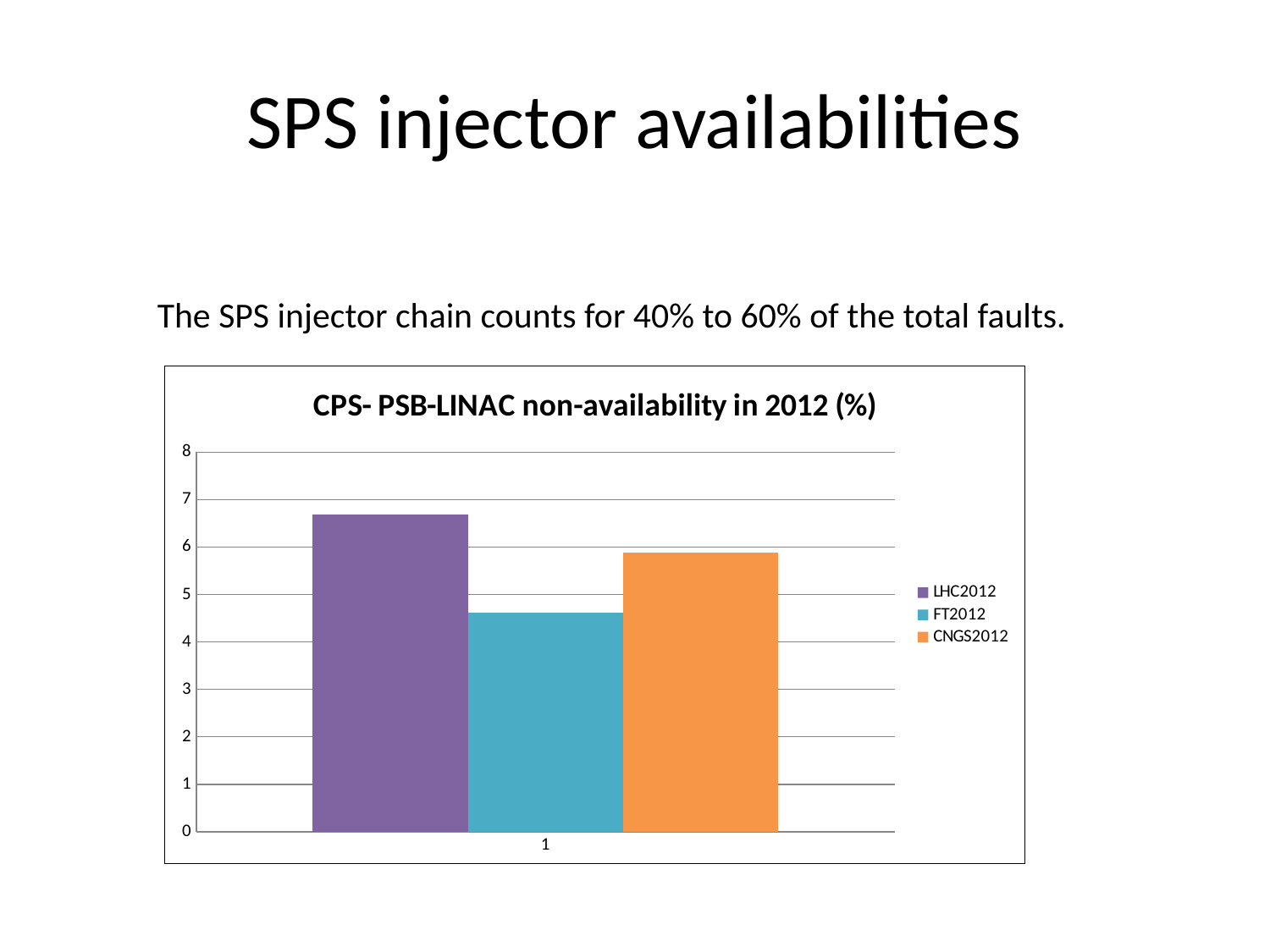
What is the title of the chart? CPS- PSB-LINAC non-availability in 2012 (%) Is the value for FT2012 greater or less than 4? greater Is the value for LHC2012 greater or less than 6? greater Which is larger, the value for LHC2012 or the value for CNGS2012? LHC2012 Is the value for FT2012 greater or less than 5? less Which is larger, the value for FT2012 or the value for CNGS2012? CNGS2012 What kind of chart is shown on the slide? bar chart Which colour is used for the CNGS2012 series? orange Which series has the highest bar? LHC2012 Which series has the lowest bar? FT2012 How many series does the legend list? 3